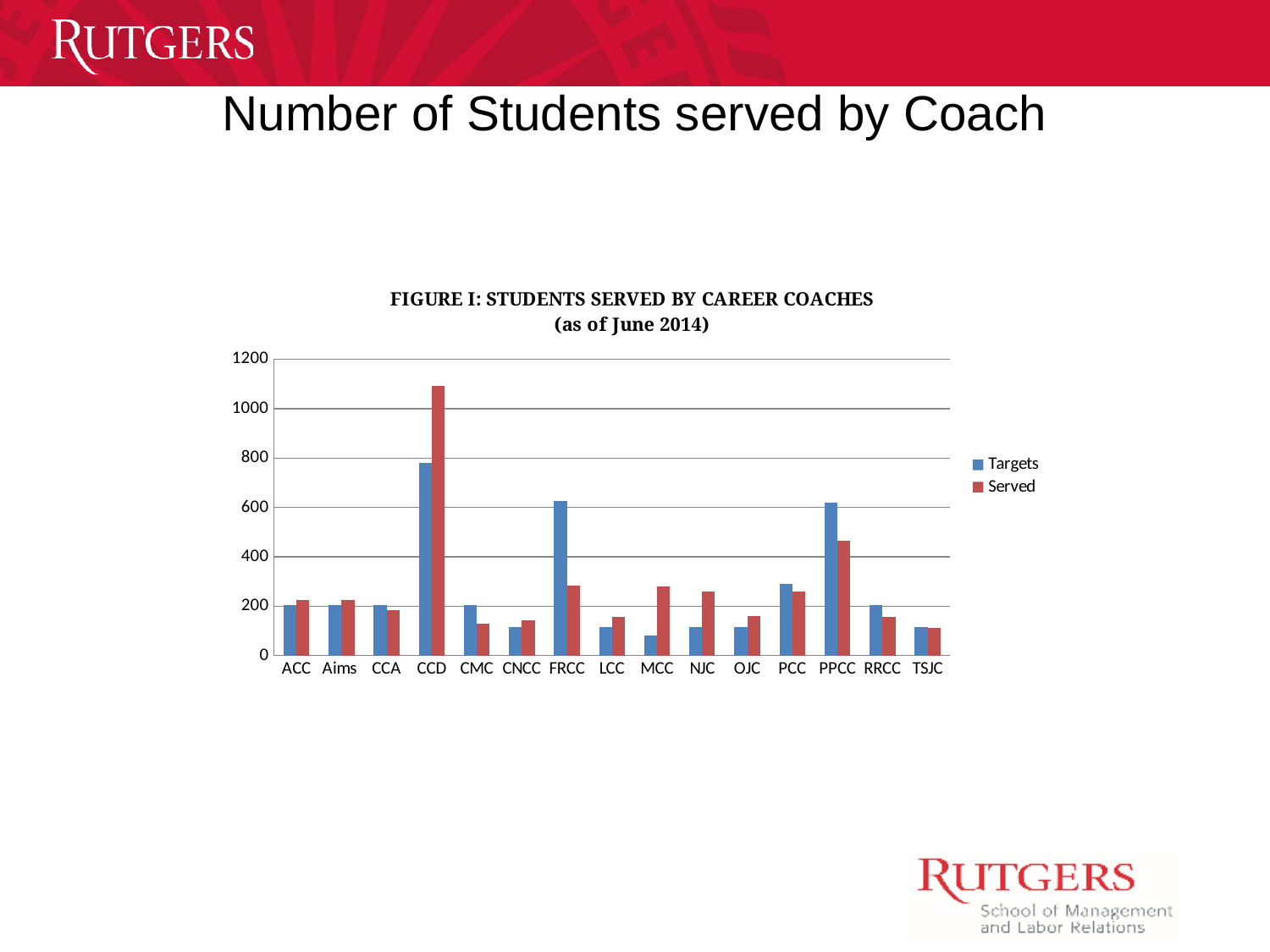
Which category has the highest Targets value? CCD Is the Served value for PPCC greater or less than 400? greater Is the Targets value for FRCC greater or less than 600? greater Is the Served value for CCD greater or less than 1000? greater For FRCC, which is larger, Targets or Served? Targets For MCC, which is larger, Targets or Served? Served Which category has the lowest Targets value? MCC How many series does the legend list? 2 What is the title of the figure shown on the slide? FIGURE I: STUDENTS SERVED BY CAREER COACHES (as of June 2014) What kind of chart is shown on the slide? bar chart How many coach categories are shown along the x axis? 15 Which category has the highest Served value? CCD